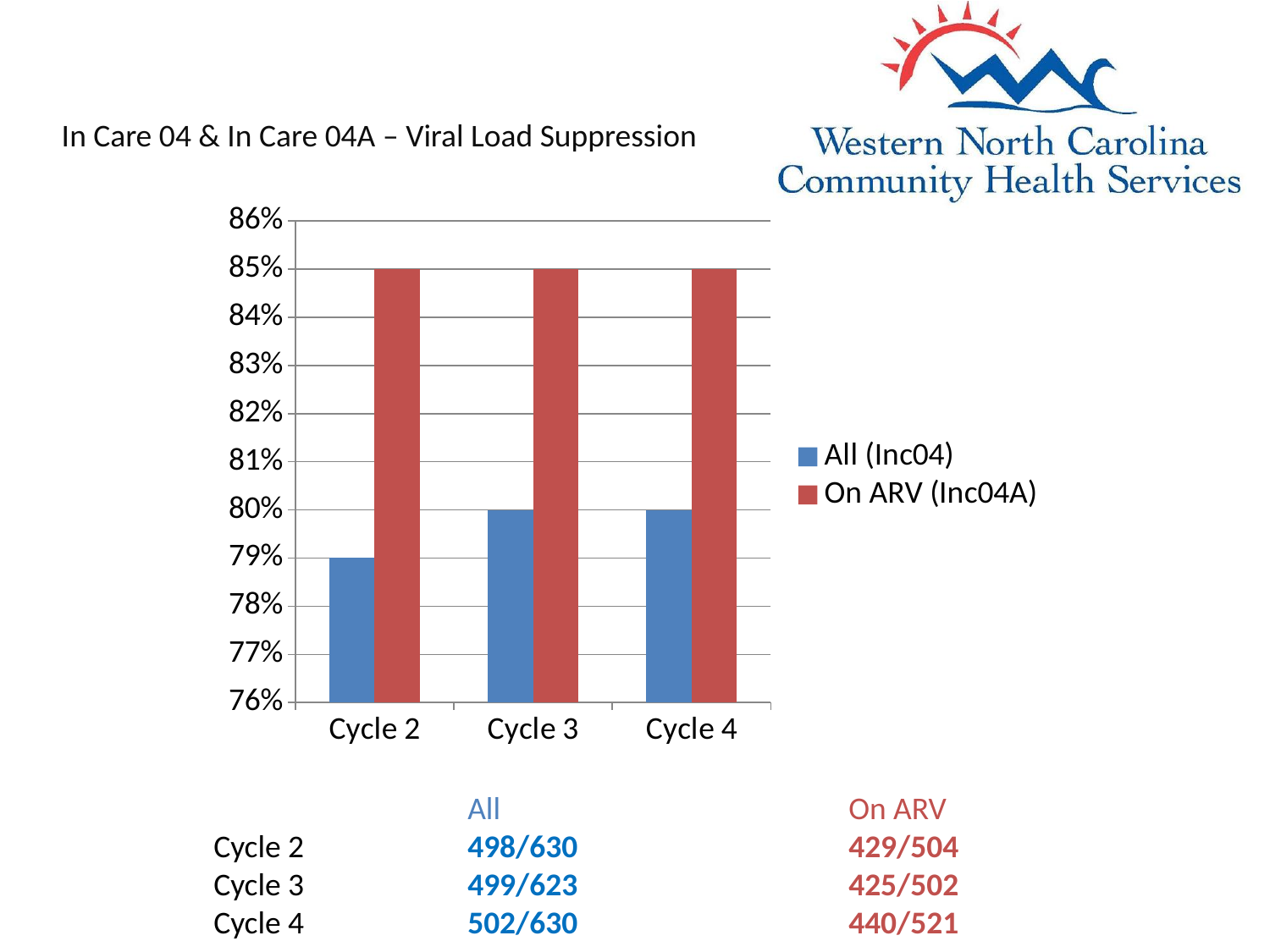
Does the All (Inc04) series rise or fall from Cycle 2 to Cycle 3? rise What is the value for All (Inc04) in Cycle 2? 79% Which cycle has the lowest value for All (Inc04)? Cycle 2 What is the difference between On ARV (Inc04A) and All (Inc04) in Cycle 2? 6% Which is larger in Cycle 3, All (Inc04) or On ARV (Inc04A)? On ARV (Inc04A) How many series does the legend list? 2 How many cycles are shown on the x axis of the chart? 3 What type of chart is shown on the slide? bar chart What is the value for All (Inc04) in Cycle 4? 80% Is the value for All (Inc04) in Cycle 3 greater or less than 82%? less What is the value for On ARV (Inc04A) in Cycle 3? 85% What colour are the On ARV (Inc04A) bars? red